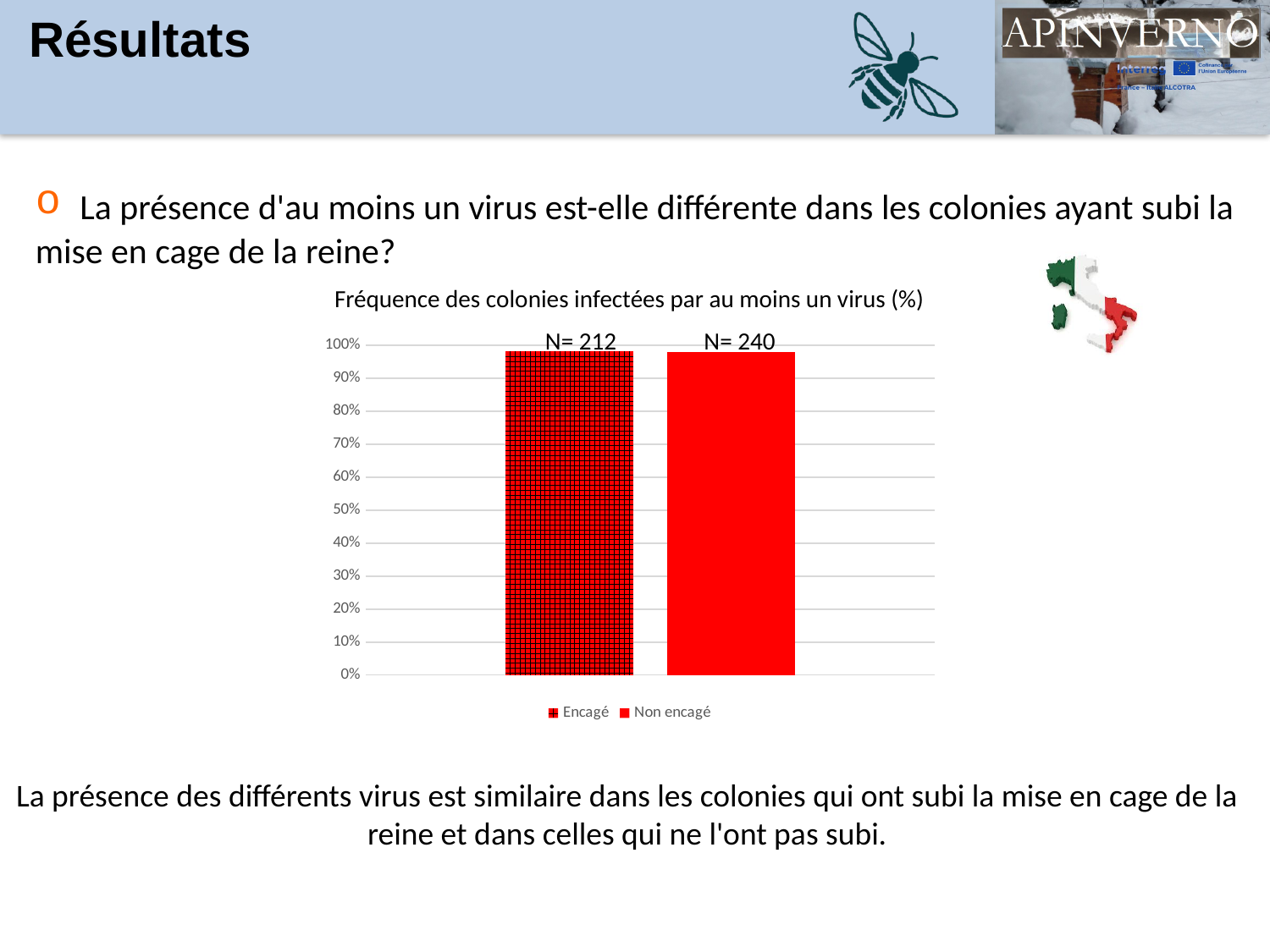
What sample size label is printed above the Non encagé bar? N= 240 How many series does the chart legend list? 2 What kind of chart is shown on the slide? bar chart Is the value for Encagé greater or less than 50%? greater Is the value for Non encagé greater or less than 90%? greater What is the title of the chart? Fréquence des colonies infectées par au moins un virus (%) How many bars are plotted in the chart? 2 Is the value for Encagé greater or less than 90%? greater What sample size label is printed above the Encagé bar? N= 212 What are the two series named in the legend? Encagé and Non encagé